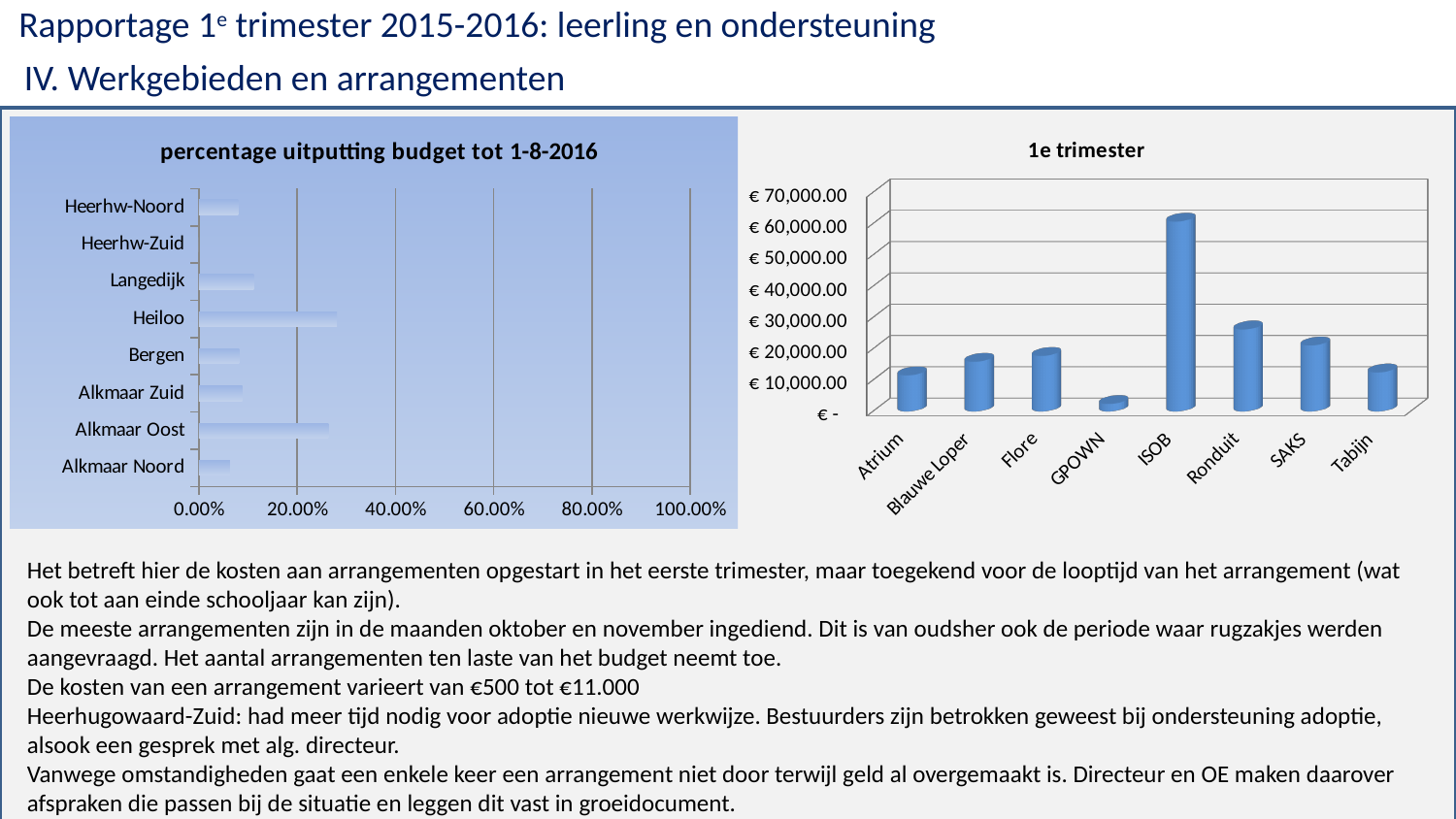
On the chart titled 'percentage uitputting budget tot 1-8-2016', which is larger, the value for Heiloo or the value for Bergen? Heiloo What kind of chart is the chart titled '1e trimester'? bar chart On the chart titled '1e trimester', which is larger, the value for ISOB or the value for Ronduit? ISOB On the chart titled '1e trimester', which category has the lowest value? GPOWN On the chart titled '1e trimester', which category has the highest value? ISOB On the chart titled '1e trimester', is the value for GPOWN greater or less than € 10,000.00? less On the chart titled '1e trimester', is the value for Ronduit greater or less than € 20,000.00? greater On the chart titled 'percentage uitputting budget tot 1-8-2016', how many categories are listed? 8 On the chart titled '1e trimester', is the value for ISOB greater or less than € 50,000.00? greater On the chart titled '1e trimester', how many categories are shown on the x axis? 8 On the chart titled 'percentage uitputting budget tot 1-8-2016', which category has the highest value? Heiloo